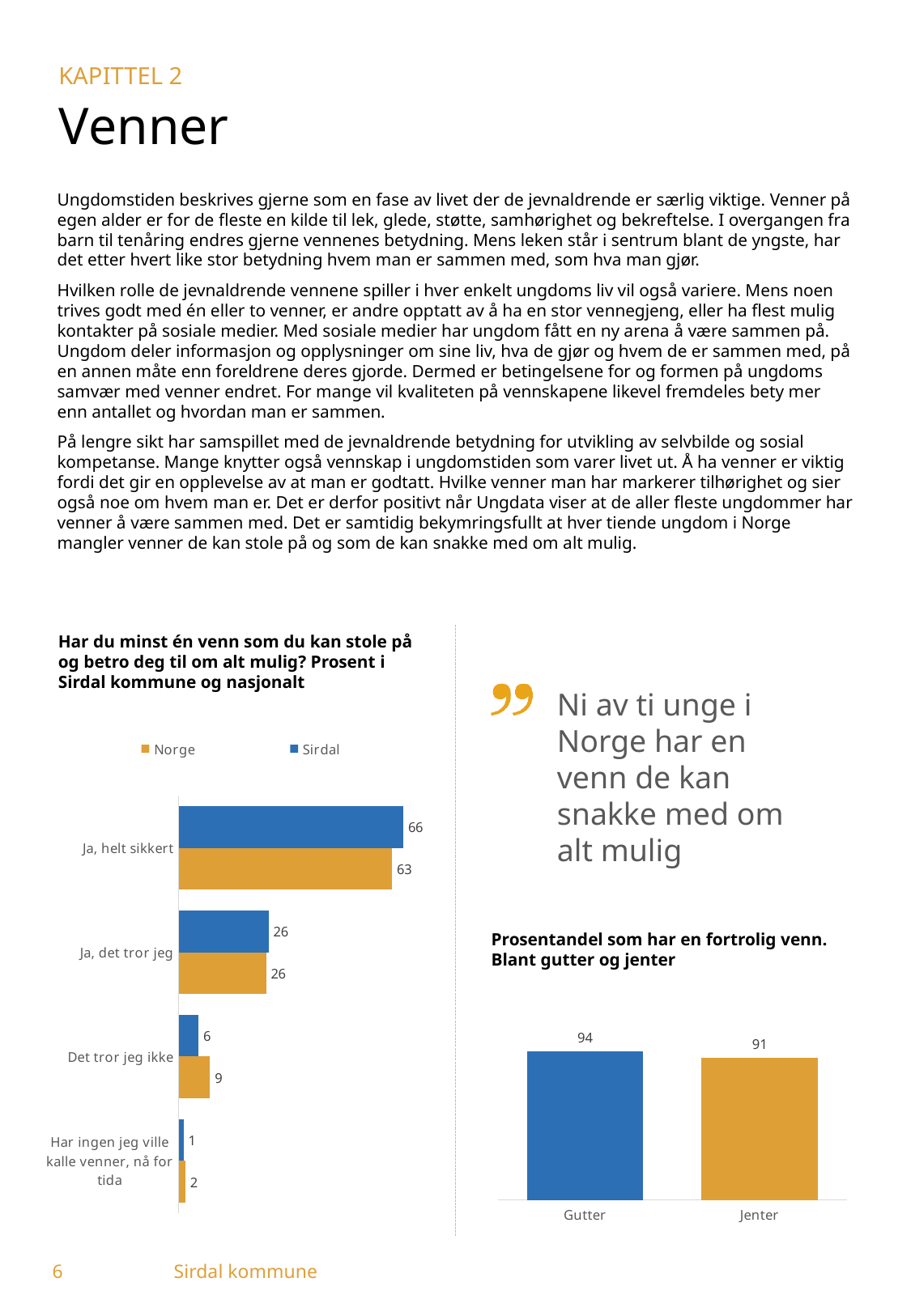
In the chart titled "Har du minst én venn som du kan stole på og betro deg til om alt mulig?", which category has the lowest value for Norge? Har ingen jeg ville kalle venner, nå for tida In the chart titled "Har du minst én venn som du kan stole på og betro deg til om alt mulig?", how many series does the legend list? 2 In the chart titled "Har du minst én venn som du kan stole på og betro deg til om alt mulig?", which category has the highest value for Sirdal? Ja, helt sikkert In the chart titled "Prosentandel som har en fortrolig venn. Blant gutter og jenter", what is the value for Jenter? 91 In the chart titled "Har du minst én venn som du kan stole på og betro deg til om alt mulig?", what is the value for Norge for "Det tror jeg ikke"? 9 In the chart titled "Har du minst én venn som du kan stole på og betro deg til om alt mulig?", what is the value for Norge for "Har ingen jeg ville kalle venner, nå for tida"? 2 In the chart titled "Har du minst én venn som du kan stole på og betro deg til om alt mulig?", which is larger for "Det tror jeg ikke", Norge or Sirdal? Norge In the chart titled "Har du minst én venn som du kan stole på og betro deg til om alt mulig?", what is the value for Sirdal for "Ja, helt sikkert"? 66 In the chart titled "Har du minst én venn som du kan stole på og betro deg til om alt mulig?", how many categories are shown? 4 In the chart titled "Har du minst én venn som du kan stole på og betro deg til om alt mulig?", what is the difference between Sirdal and Norge for "Ja, helt sikkert"? 3 What kind of chart is the one titled "Prosentandel som har en fortrolig venn. Blant gutter og jenter"? Bar chart In the chart titled "Prosentandel som har en fortrolig venn. Blant gutter og jenter", what is the difference between Gutter and Jenter? 3